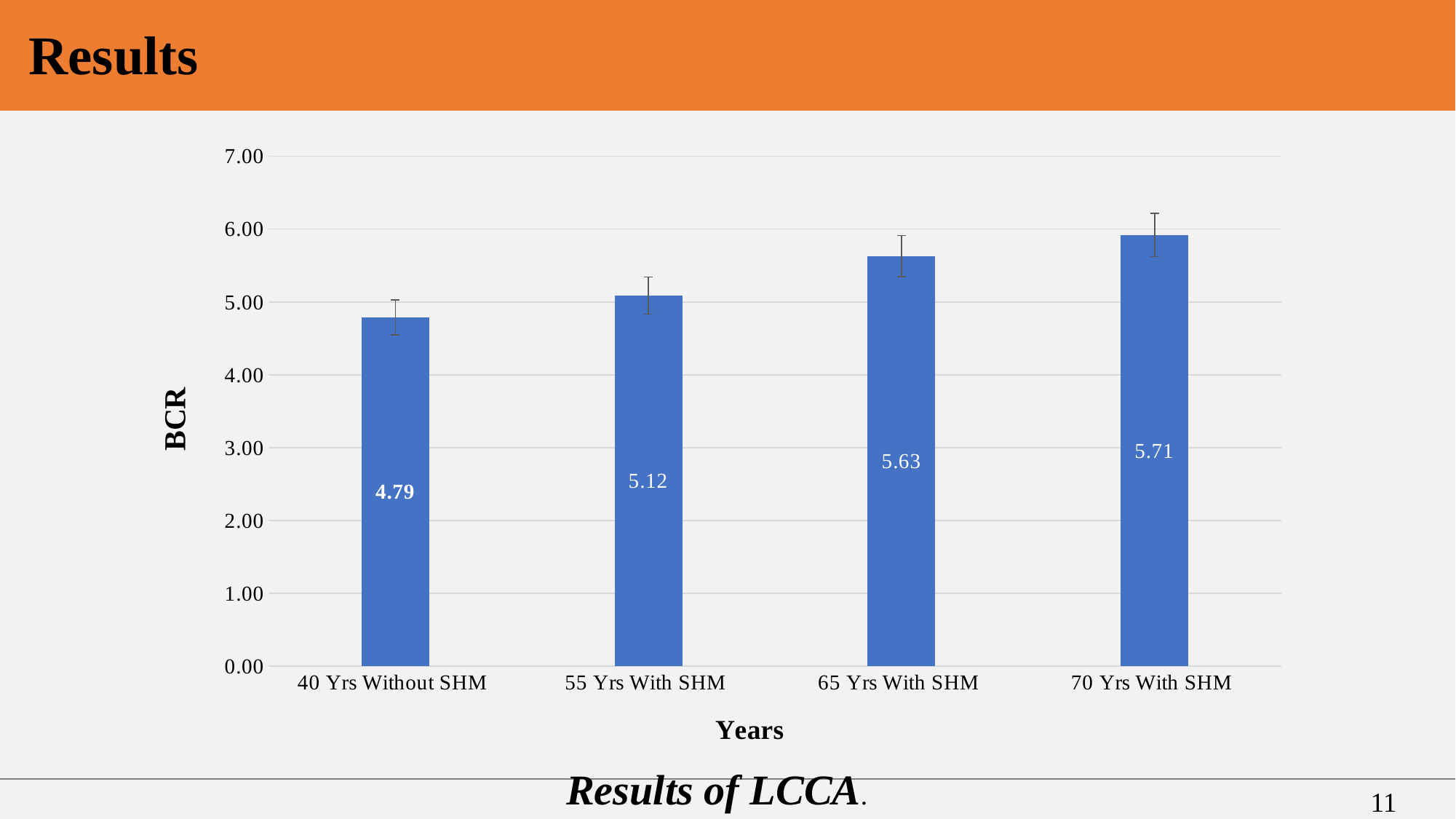
What is the BCR value for 70 Yrs With SHM? 5.71 Is the BCR value for 40 Yrs Without SHM greater or less than 5.00? less What is the BCR value for 65 Yrs With SHM? 5.63 What is the difference in BCR between 70 Yrs With SHM and 40 Yrs Without SHM? 0.92 Do the BCR values rise or fall from left to right along the x axis? rise What is the difference in BCR between 55 Yrs With SHM and 40 Yrs Without SHM? 0.33 How many categories are shown on the x axis? 4 Which category has the highest BCR? 70 Yrs With SHM What is the BCR value for 40 Yrs Without SHM? 4.79 Which has a larger BCR, 55 Yrs With SHM or 65 Yrs With SHM? 65 Yrs With SHM Which category has the lowest BCR? 40 Yrs Without SHM What kind of chart is shown on the slide? bar chart